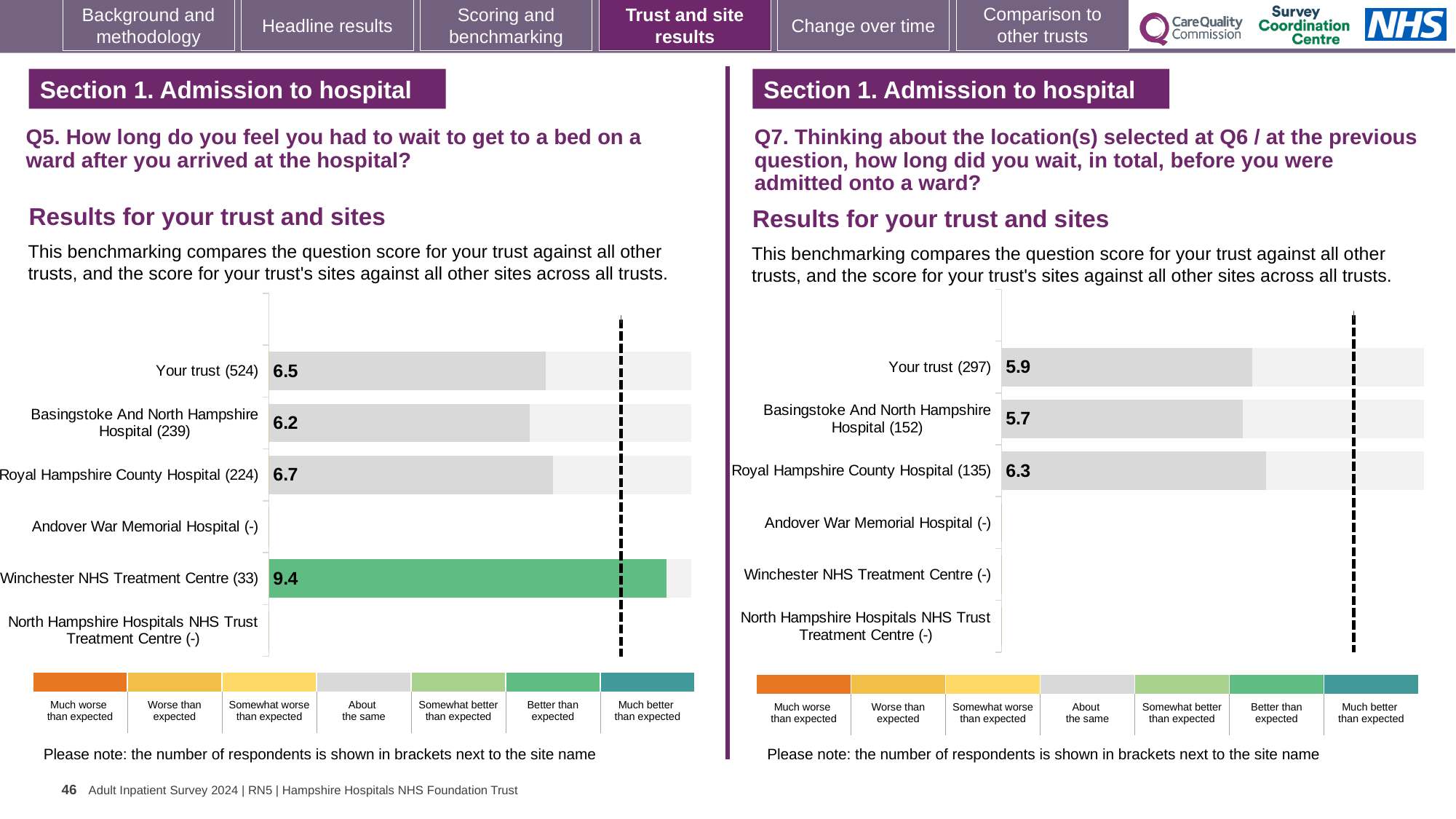
On the Q5 chart (left), what colour is the bar for Winchester NHS Treatment Centre (33)? Green What type of chart is used on the Q5 chart (left)? Bar chart On the Q7 chart (right), what is the score for Royal Hampshire County Hospital (135)? 6.3 On the Q7 chart (right), which site has the highest score? Royal Hampshire County Hospital (135) On the Q5 chart (left), which site has the highest score? Winchester NHS Treatment Centre (33) On the Q5 chart (left), what is the difference between the scores for Royal Hampshire County Hospital (224) and Basingstoke And North Hampshire Hospital (239)? 0.5 On the Q7 chart (right), which is larger: the score for Royal Hampshire County Hospital (135) or Basingstoke And North Hampshire Hospital (152)? Royal Hampshire County Hospital (135) On the Q7 chart (right), what is the score for Your trust (297)? 5.9 On the Q5 chart (left), what is the score for Winchester NHS Treatment Centre (33)? 9.4 On the Q5 chart (left), what is the score for Your trust (524)? 6.5 On the Q5 chart (left), which of the sites with a plotted score has the lowest score? Basingstoke And North Hampshire Hospital (239) On the Q7 chart (right), what is the difference between the scores for Your trust (297) and Basingstoke And North Hampshire Hospital (152)? 0.2